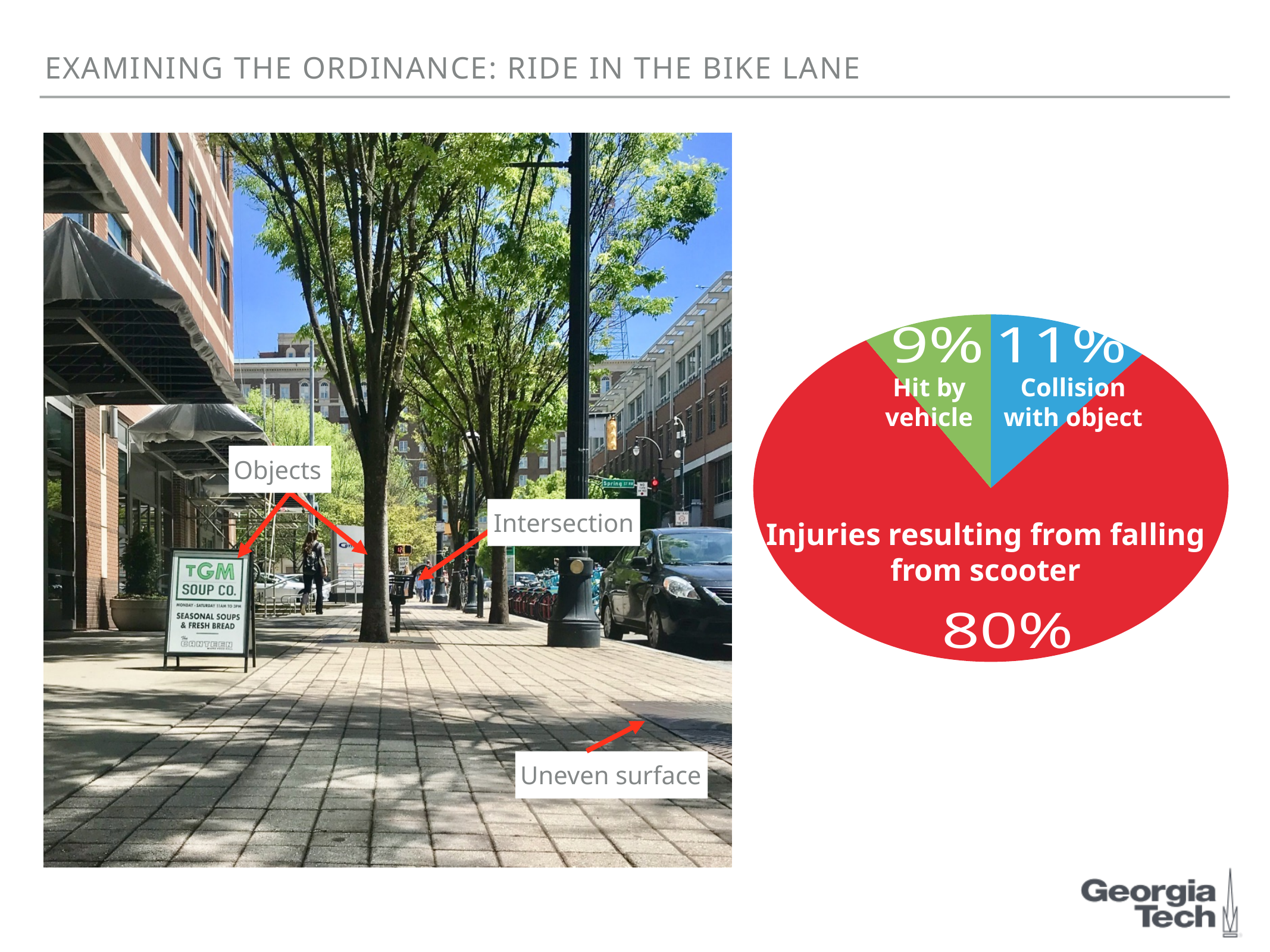
What is the difference in percentage points between the 'Collision with object' slice and the 'Hit by vehicle' slice? 2 What percentage of the pie chart is labelled 'Collision with object'? 11% Which slice of the pie chart is the largest? Injuries resulting from falling from scooter How many slices does the pie chart have? 3 What colour is the 'Hit by vehicle' slice of the pie chart? green Which is larger in the pie chart: 'Hit by vehicle' or 'Collision with object'? Collision with object What percentage of the pie chart is labelled 'Hit by vehicle'? 9% What is the difference in percentage points between the 'Injuries resulting from falling from scooter' slice and the 'Collision with object' slice? 69 Which slice of the pie chart is the smallest? Hit by vehicle What kind of chart is shown on the right side of the slide? pie chart What colour is the 'Injuries resulting from falling from scooter' slice of the pie chart? red What percentage of the pie chart is labelled 'Injuries resulting from falling from scooter'? 80%